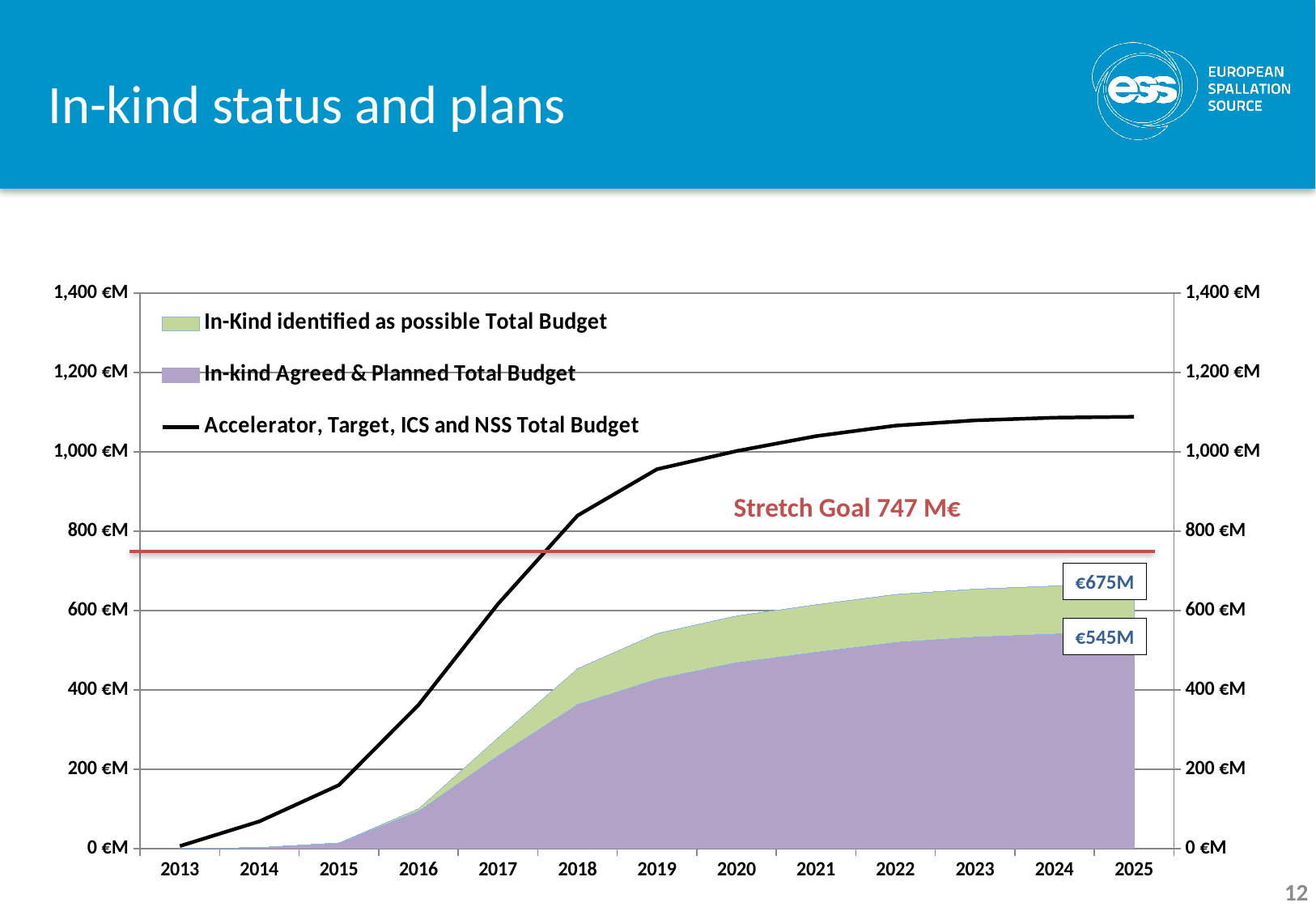
What value is labelled for the In-kind Agreed & Planned Total Budget at the end of the chart (2025)? €545M In 2025, which is larger: the Accelerator, Target, ICS and NSS Total Budget or the In-Kind identified as possible Total Budget? Accelerator, Target, ICS and NSS Total Budget Is the Accelerator, Target, ICS and NSS Total Budget in 2015 greater or less than 200 €M? less Is the In-kind Agreed & Planned Total Budget in 2020 greater or less than 400 €M? greater What is the difference between the €675M and €545M labels shown at 2025? €130M Does the Accelerator, Target, ICS and NSS Total Budget line rise or fall from 2013 to 2025? rise What value is labelled for the In-Kind identified as possible Total Budget at the end of the chart (2025)? €675M How many series does the chart legend list? 3 What is the value of the Stretch Goal marked by the red line? 747 M€ What colour is used for the In-kind Agreed & Planned Total Budget series? purple Is the Accelerator, Target, ICS and NSS Total Budget in 2019 greater or less than 800 €M? greater How many years are shown on the x axis of the chart? 13